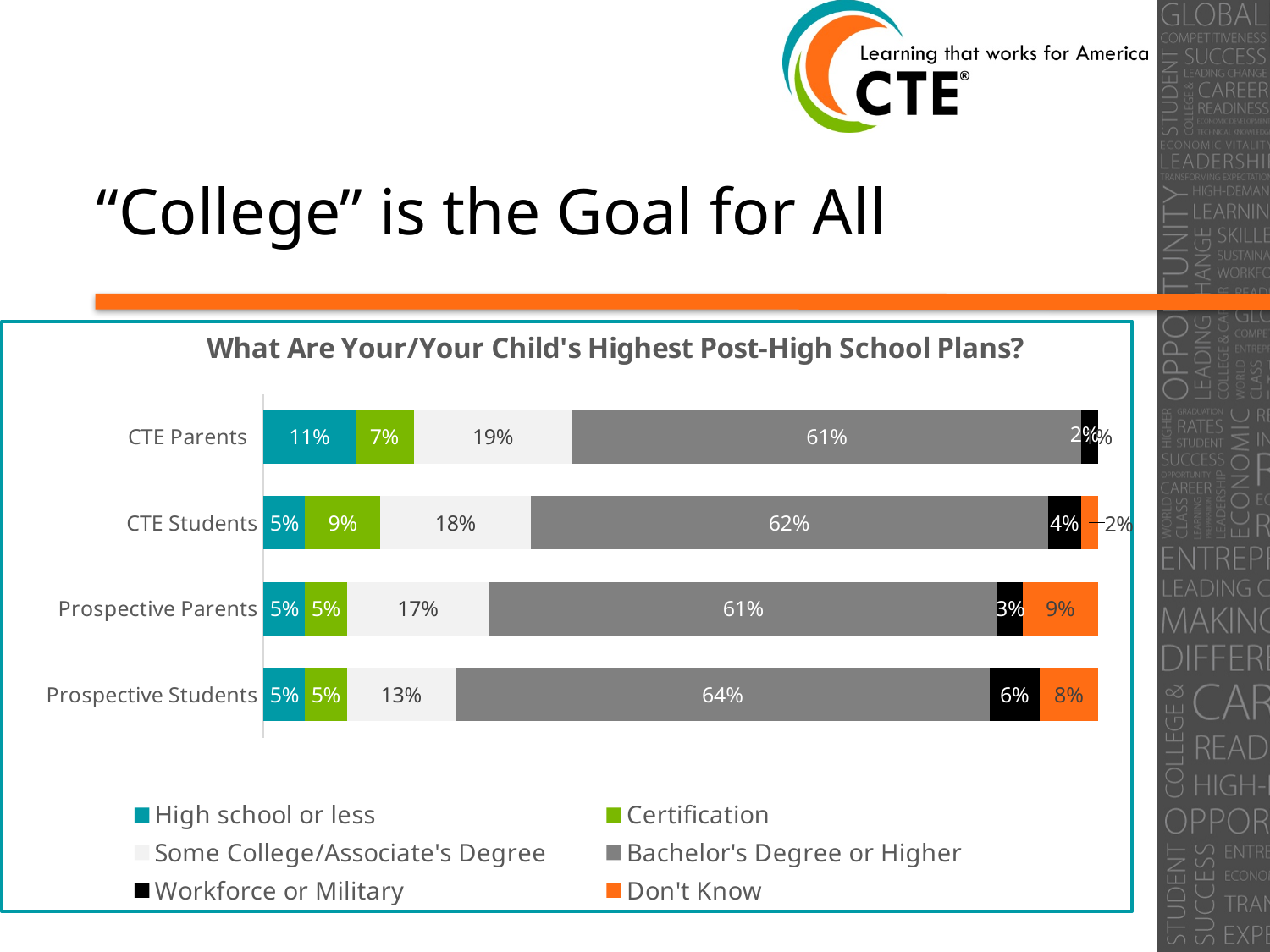
What kind of chart is shown on the slide? Stacked bar chart What is the title of the chart? What Are Your/Your Child's Highest Post-High School Plans? Which has a larger Don't Know value, Prospective Parents or Prospective Students? Prospective Parents Which group has the lowest Some College/Associate's Degree value? Prospective Students What is the Workforce or Military value for Prospective Students? 6% What percentage of Prospective Students plan for a Bachelor's Degree or Higher? 64% How many series does the legend list? 6 What is the Certification value for CTE Students? 9% How many respondent groups (categories) are shown on the chart? 4 What is the difference between the Some College/Associate's Degree values for CTE Parents and Prospective Students? 6 percentage points What is the High school or less value for CTE Parents? 11% Which group has the highest Bachelor's Degree or Higher value? Prospective Students